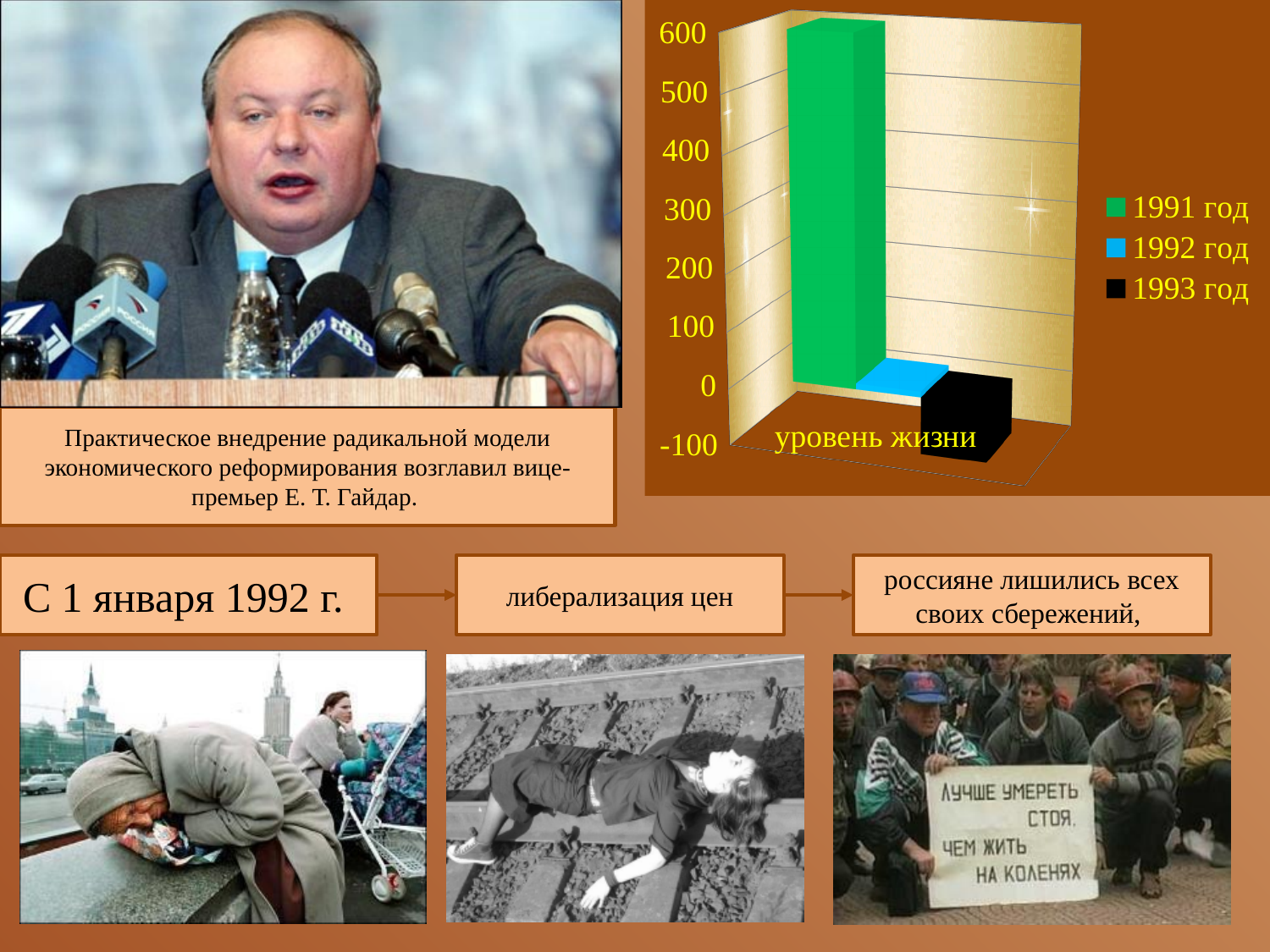
Is the value for 1993 год greater or less than 0? less Which year has the lowest value for уровень жизни? 1993 год Which is larger, the value for 1991 год or the value for 1992 год? 1991 год What kind of chart is shown on the slide? bar chart Is the value for 1991 год greater or less than 500? greater How many categories are plotted on the x axis of the chart? 1 Do the values for уровень жизни rise or fall from 1991 год to 1993 год? fall What is the category label shown on the x axis of the chart? уровень жизни How many series does the chart legend list? 3 What colour represents 1993 год in the chart legend? black Is the value for 1992 год greater or less than 300? less Which year has the highest value for уровень жизни? 1991 год